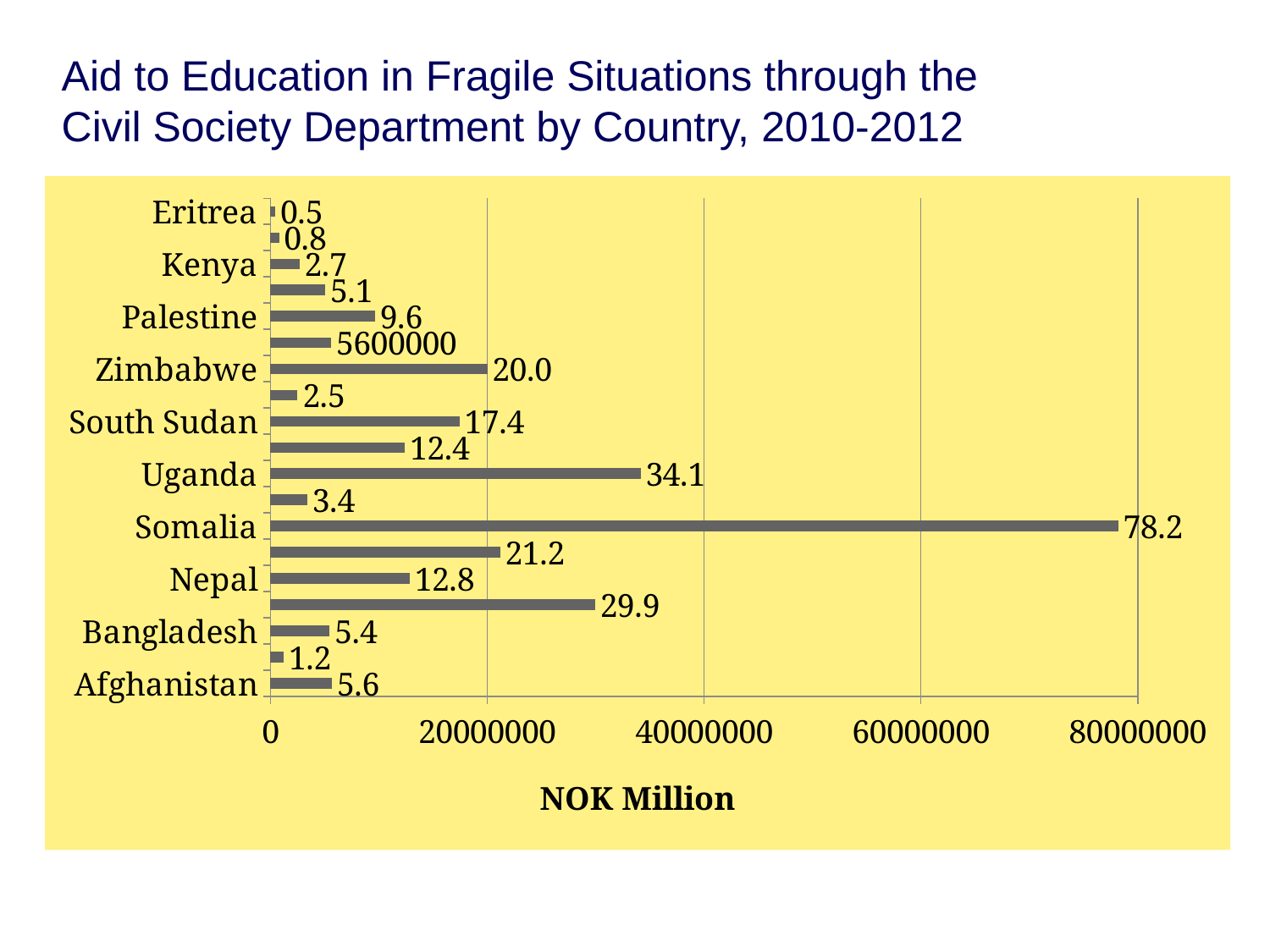
What is the value for Somalia? 78.2 Which labelled country has the lowest value? Eritrea Which country has the highest value? Somalia What is the difference between the values for Zimbabwe and South Sudan? 2.6 What is the value for Uganda? 34.1 Which is larger, the value for Afghanistan or the value for Bangladesh? Afghanistan What is the title of the horizontal axis? NOK Million What is the value for Eritrea? 0.5 What kind of chart is shown on the slide? bar chart Is the value for Somalia greater or less than 60000000 on the axis? greater What is the value for Zimbabwe? 20.0 What is the difference between the values for Somalia and Uganda? 44.1